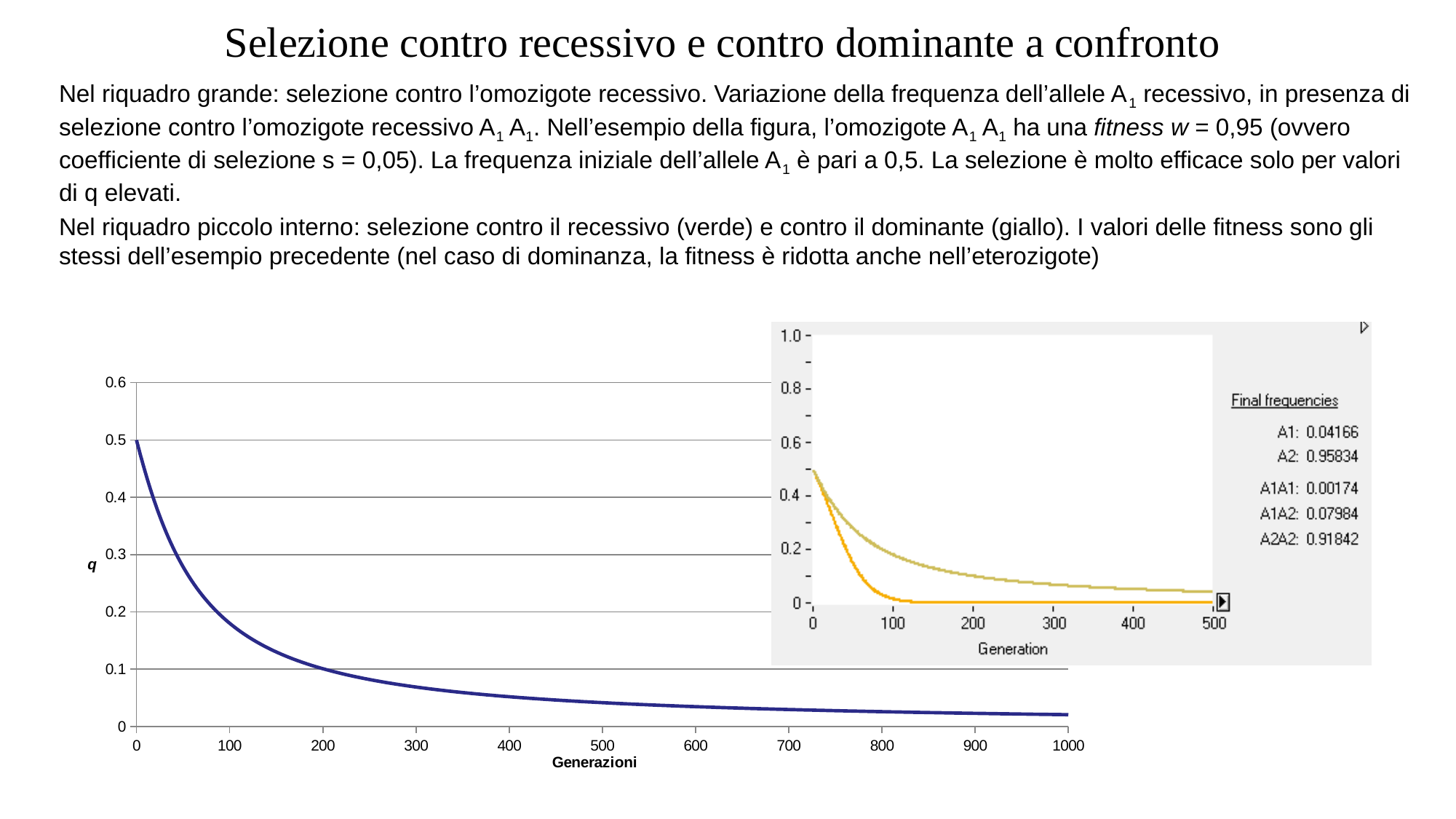
In the large chart on the left, what is the label of the x axis? Generazioni In the small inset chart on the right, what is the final frequency of A1A2? 0.07984 How many lines are plotted in the small inset chart on the right? 2 In the small inset chart on the right, what is the final frequency of A2A2? 0.91842 In the large chart on the left, is the value of q at generation 500 greater or less than 0.1? less In the small inset chart on the right, what is the final frequency of A1? 0.04166 In the small inset chart on the right, is the value of the green line at generation 300 greater or less than 0.2? less What kind of chart is the large chart on the left? line chart In the large chart on the left, does q rise or fall as the generations increase? fall In the large chart on the left, what is the value of q at generation 0? 0.5 In the small inset chart on the right, at generation 100, which line is higher, the green one or the yellow one? the green one